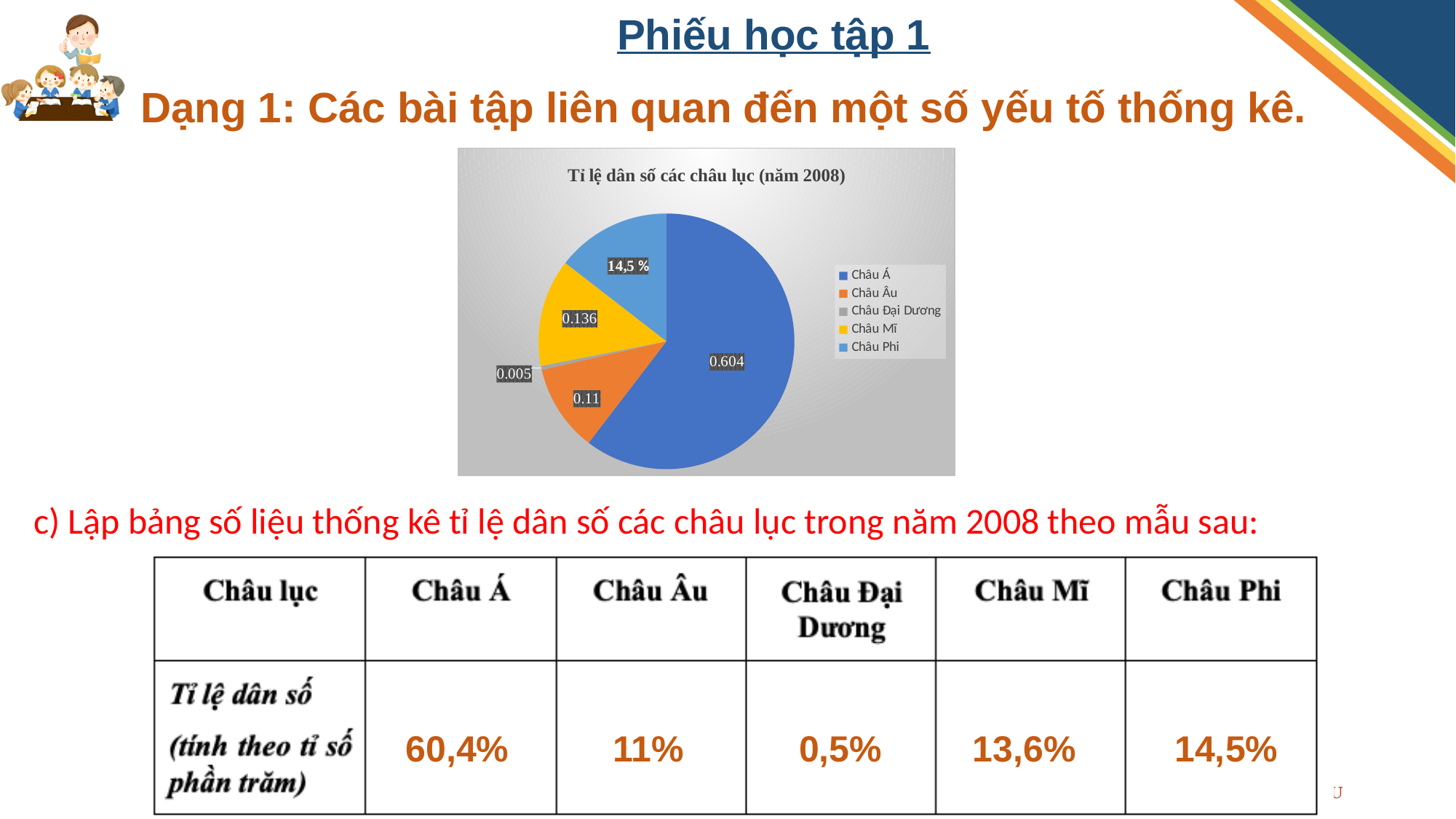
How many continents (slices) does the pie chart show? 5 Which continent has the smallest slice in the pie chart? Châu Đại Dương What kind of chart is shown on the slide? Pie chart What value is labelled on the Châu Đại Dương slice of the pie chart? 0.005 What is the difference between the labelled values for Châu Á and Châu Âu in the pie chart? 0.494 Which continent has the largest slice in the pie chart? Châu Á What value is labelled on the Châu Á slice of the pie chart? 0.604 What label is shown on the Châu Phi slice of the pie chart? 14,5 % What value is labelled on the Châu Mĩ slice of the pie chart? 0.136 What value is labelled on the Châu Âu slice of the pie chart? 0.11 What is the title of the pie chart? Tỉ lệ dân số các châu lục (năm 2008) Which slice is larger in the pie chart, Châu Mĩ or Châu Âu? Châu Mĩ